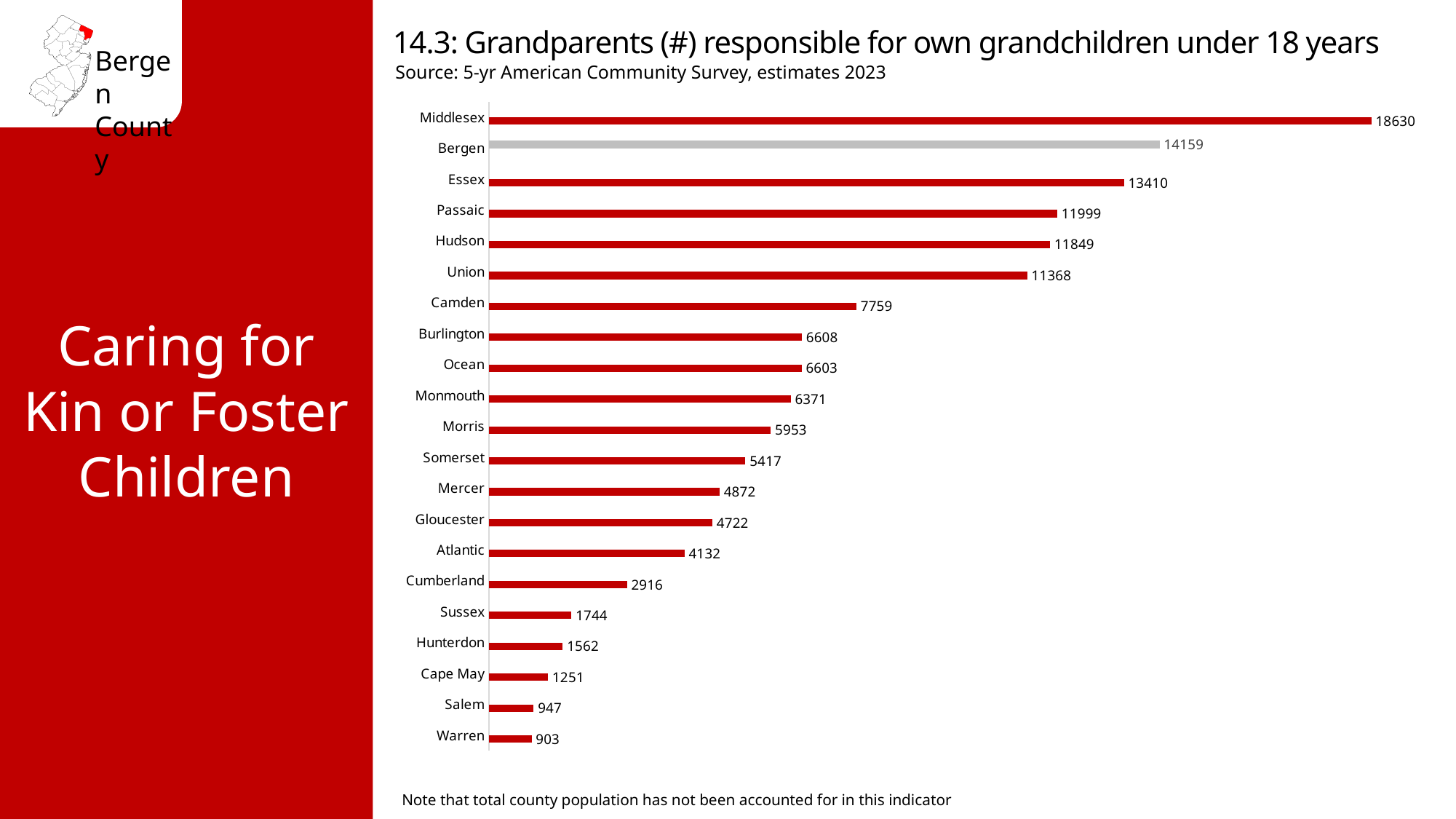
Which county has the highest value? Middlesex What kind of chart is shown on the slide? Bar chart Which is larger, the value for Hudson or the value for Union? Hudson What is the value for Bergen? 14159 Which is larger, the value for Sussex or the value for Hunterdon? Sussex What is the value for Cape May? 1251 What is the difference between the values for Essex and Passaic? 1411 How many counties are shown in the chart? 21 Which county's bar is shown in grey rather than red? Bergen What is the difference between the values for Middlesex and Bergen? 4471 Which county has the lowest value? Warren What is the value for Camden? 7759